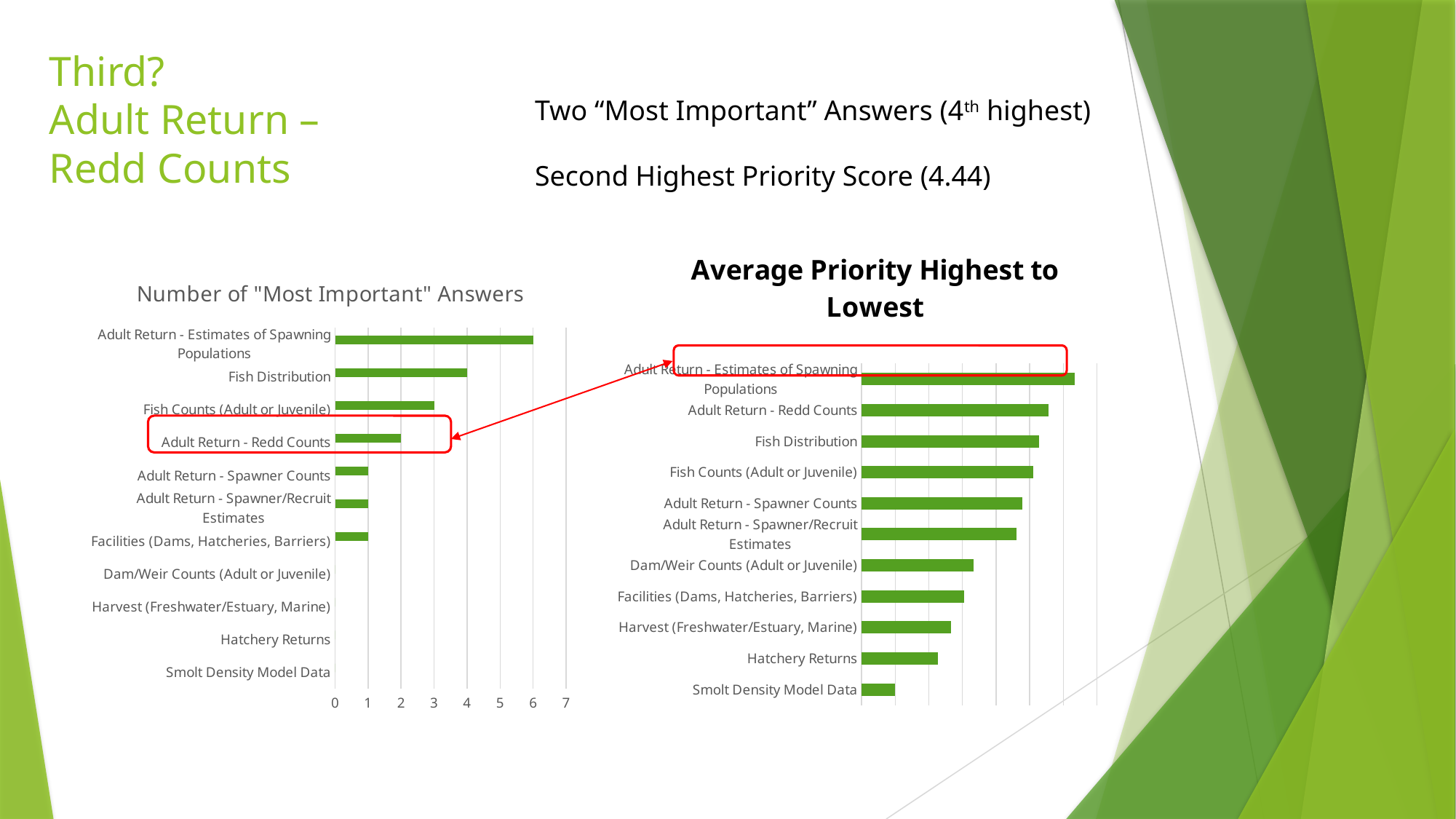
In the chart titled "Number of "Most Important" Answers", which category has the highest value? Adult Return - Estimates of Spawning Populations In the chart titled "Average Priority Highest to Lowest", which category has the lowest value? Smolt Density Model Data In the chart titled "Number of "Most Important" Answers", what is the highest value shown on the horizontal axis? 7 What kind of chart is the chart titled "Average Priority Highest to Lowest"? Bar chart In the chart titled "Number of "Most Important" Answers", what is the value for Adult Return - Estimates of Spawning Populations? 6 In the chart titled "Number of "Most Important" Answers", how many categories are shown on the vertical axis? 11 In the chart titled "Number of "Most Important" Answers", what is the value for Adult Return - Redd Counts? 2 In the chart titled "Number of "Most Important" Answers", what is the value for Fish Distribution? 4 In the chart titled "Average Priority Highest to Lowest", which is larger, Adult Return - Redd Counts or Hatchery Returns? Adult Return - Redd Counts In the chart titled "Average Priority Highest to Lowest", which category has the highest value? Adult Return - Estimates of Spawning Populations In the chart titled "Number of "Most Important" Answers", which is larger, Fish Counts (Adult or Juvenile) or Adult Return - Spawner Counts? Fish Counts (Adult or Juvenile) In the chart titled "Number of "Most Important" Answers", what is the difference between Fish Distribution and Fish Counts (Adult or Juvenile)? 1